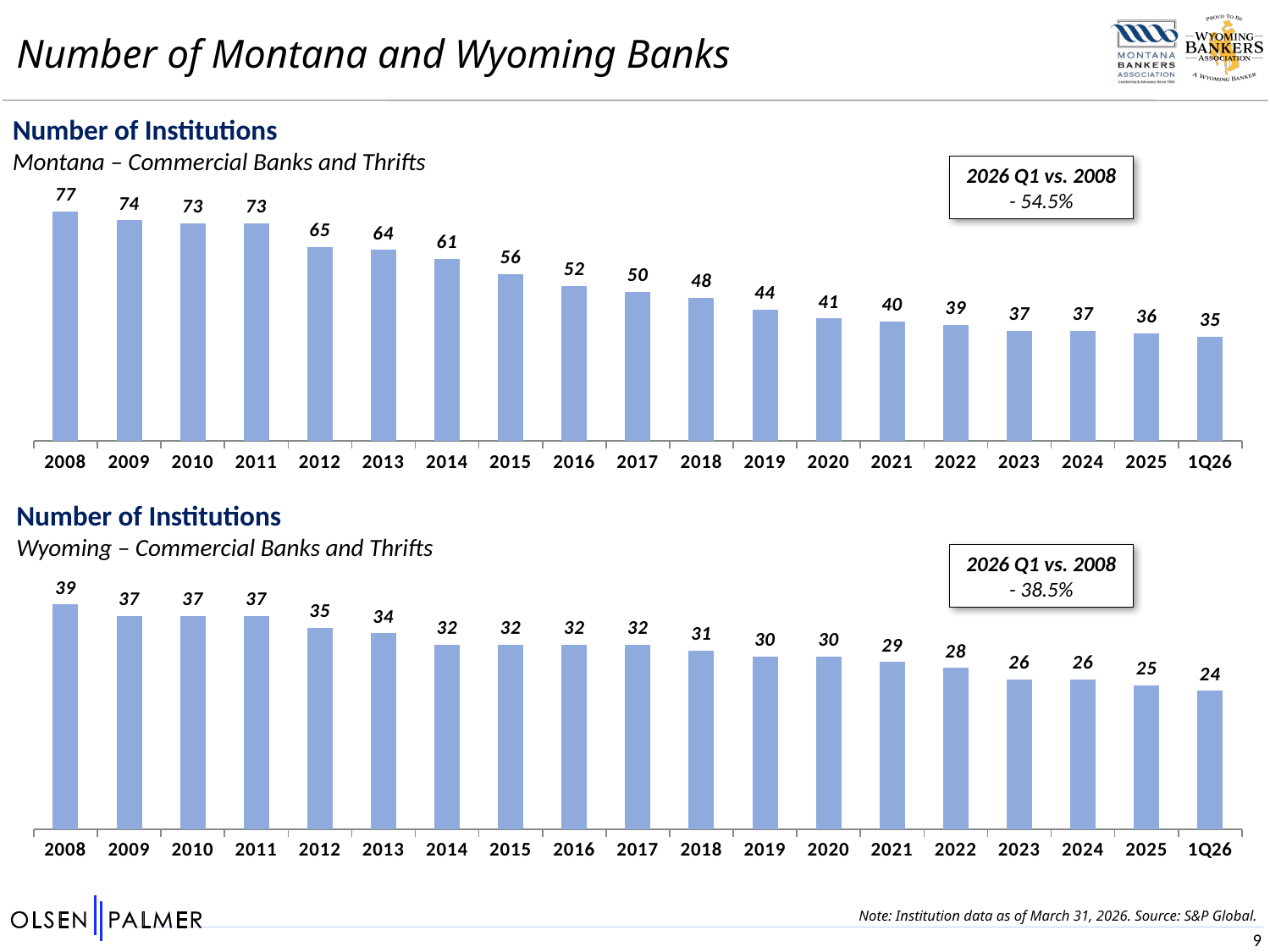
What is the subtitle of the top chart? Montana – Commercial Banks and Thrifts In the Montana chart, what is the number of institutions in 2008? 77 In the Wyoming chart, what is the difference between the 2012 value and the 2022 value? 7 In the Wyoming chart, what is the number of institutions in 1Q26? 24 In the Montana chart, which is larger, the value for 2015 or the value for 2019? 2015 In the Montana chart, which year has the lowest number of institutions? 1Q26 How many bars are plotted in the Wyoming chart? 19 In the Wyoming chart, which year has the highest number of institutions? 2008 In the Montana chart, do the values rise or fall from 2008 to 1Q26? Fall What type of chart is the Montana chart? Bar chart What percentage change does the Wyoming chart's callout box show for 2026 Q1 vs. 2008? - 38.5% In the Montana chart, what is the difference between the 2008 value and the 1Q26 value? 42